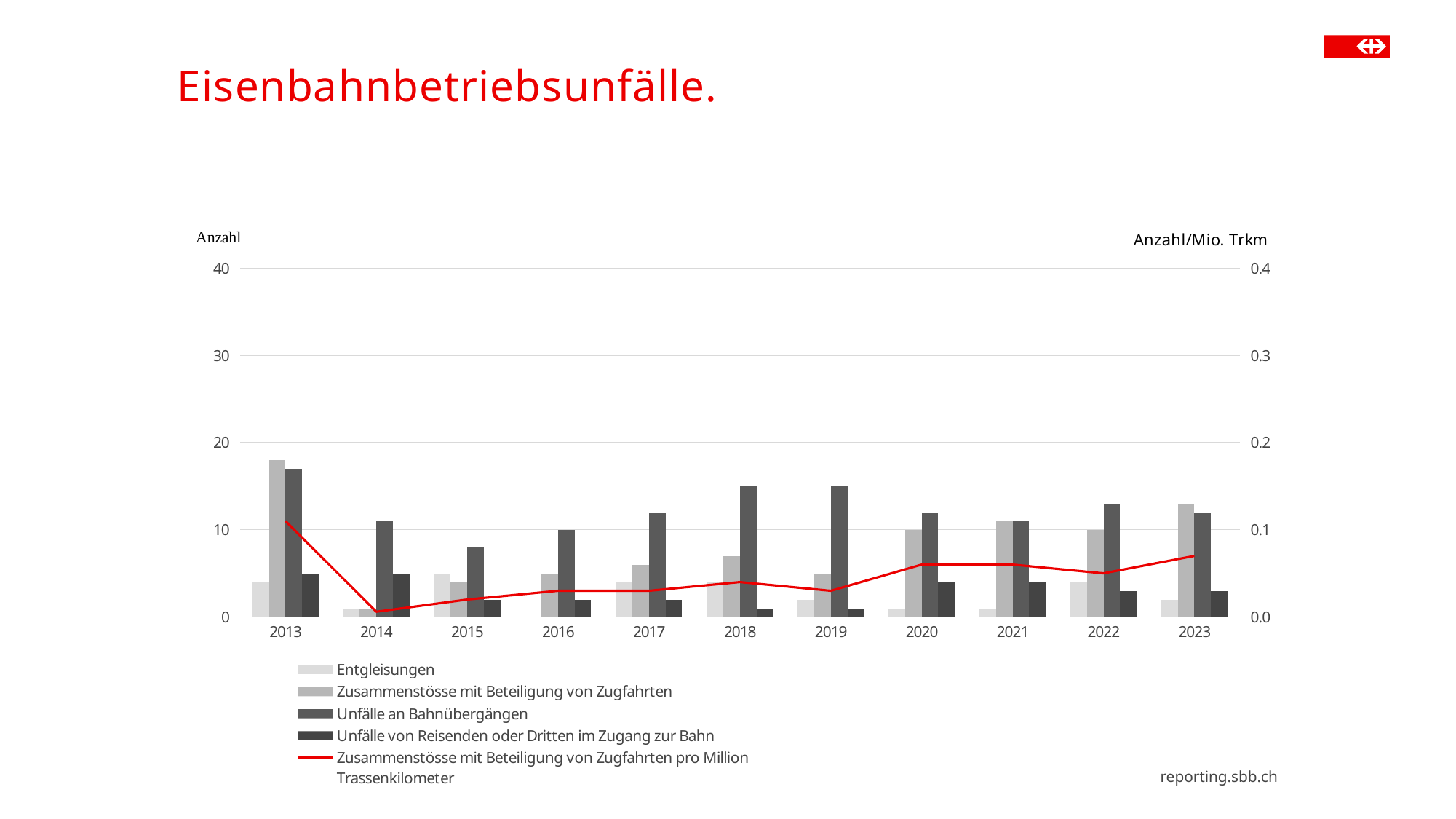
What is the label of the right-hand vertical axis? Anzahl/Mio. Trkm Which year has the larger value for Unfälle an Bahnübergängen, 2016 or 2018? 2018 Is the value for Zusammenstösse mit Beteiligung von Zugfahrten in 2013 greater or less than 10? greater How many years are shown on the x axis of the chart? 11 Does the red line rise or fall from 2013 to 2014? fall In which year is the value for Zusammenstösse mit Beteiligung von Zugfahrten lowest? 2014 What kind of chart is shown on the slide? bar and line chart In which year is the value for Zusammenstösse mit Beteiligung von Zugfahrten highest? 2013 In which year is the red line (Zusammenstösse pro Million Trassenkilometer) at its lowest? 2014 How many series does the legend of the chart list? 5 Is the value for Unfälle an Bahnübergängen in 2018 greater or less than 10? greater Is the value of the red line (Zusammenstösse pro Million Trassenkilometer) in 2023 greater or less than 0.1? less